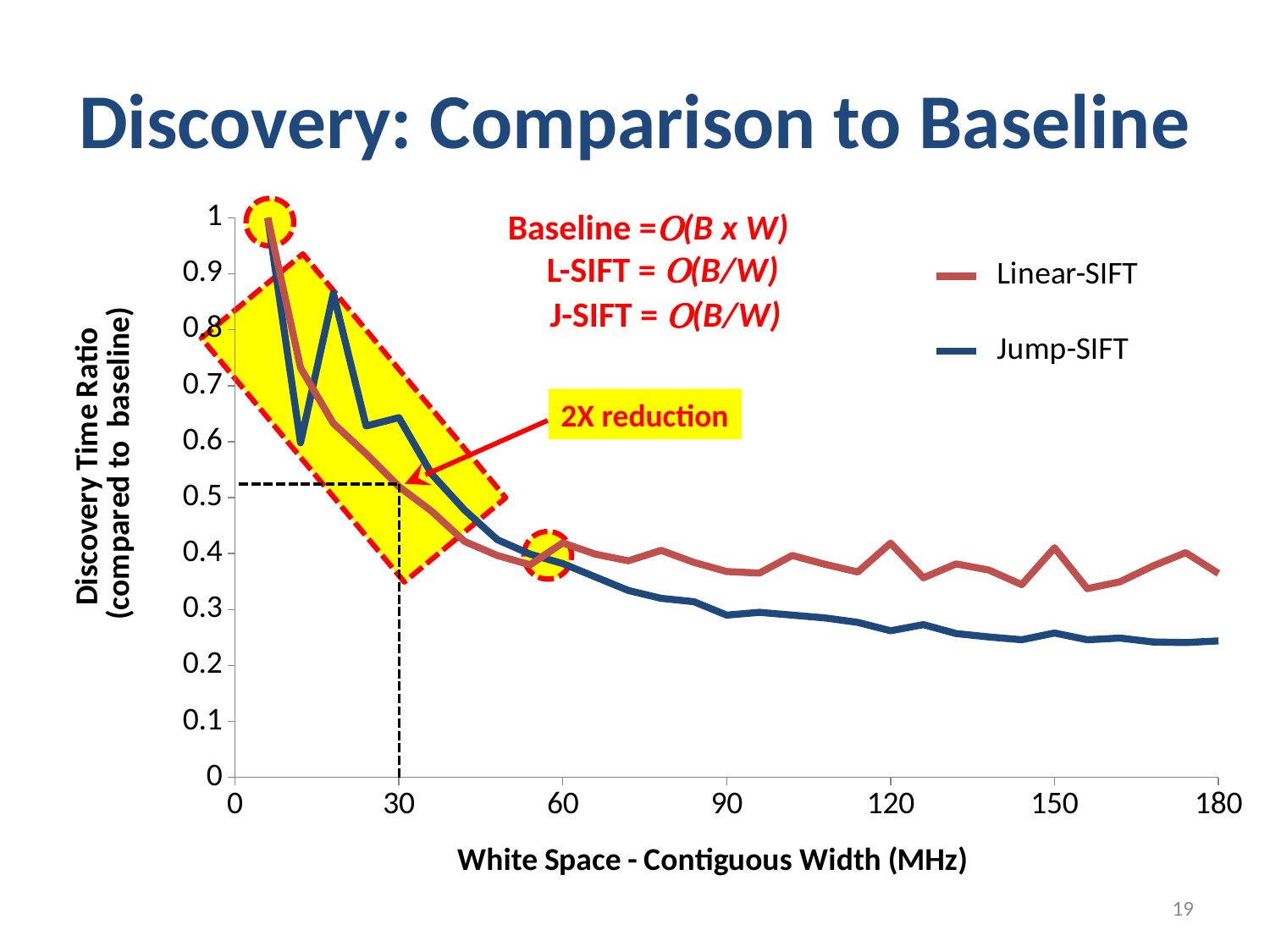
At 120 MHz, which series has the lower discovery time ratio, Linear-SIFT or Jump-SIFT? Jump-SIFT Is the Linear-SIFT value at 180 MHz greater or less than 0.3? greater Is the Jump-SIFT value at 30 MHz greater or less than 0.6? greater Is the Jump-SIFT value at 120 MHz greater or less than 0.3? less What is the label of the x axis? White Space - Contiguous Width (MHz) How many series does the legend list? 2 At 180 MHz, which series has the higher discovery time ratio, Linear-SIFT or Jump-SIFT? Linear-SIFT Do the Linear-SIFT values generally rise or fall as the white space contiguous width increases? fall Do the Jump-SIFT values generally rise or fall as the white space contiguous width increases? fall What are the two series named in the legend? Linear-SIFT and Jump-SIFT What kind of chart is shown on the slide? line chart